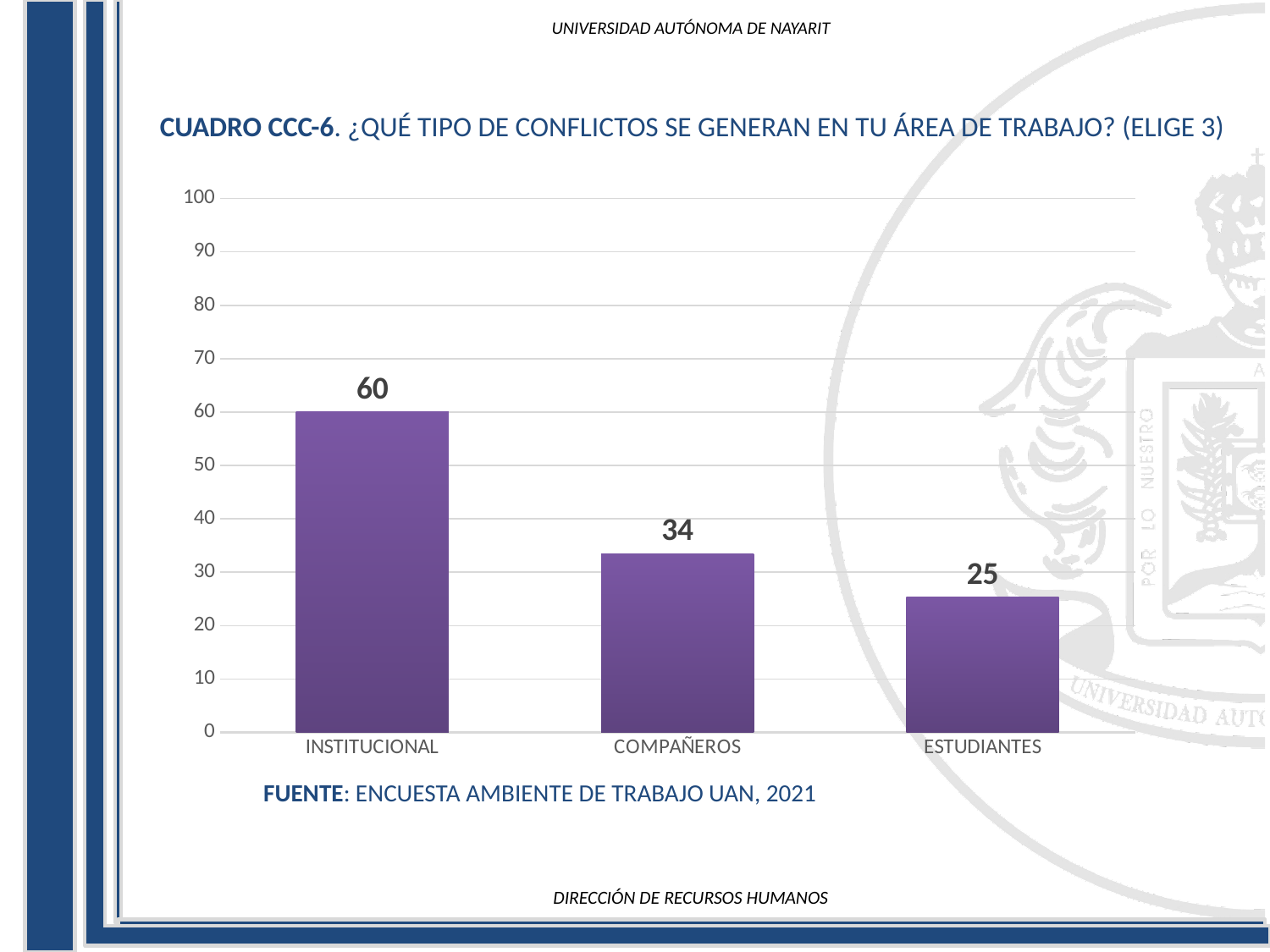
Which is larger, the value for COMPAÑEROS or the value for ESTUDIANTES? COMPAÑEROS Which category has the highest value? INSTITUCIONAL Is the value for INSTITUCIONAL greater or less than 50? greater What is the value for COMPAÑEROS? 34 What is the value for INSTITUCIONAL? 60 What is the difference between the values for INSTITUCIONAL and COMPAÑEROS? 26 How many categories are shown in the chart? 3 What kind of chart is shown on the slide? bar chart Do the values rise or fall from left to right across the categories? fall Which category has the lowest value? ESTUDIANTES What is the value for ESTUDIANTES? 25 What is the difference between the values for COMPAÑEROS and ESTUDIANTES? 9